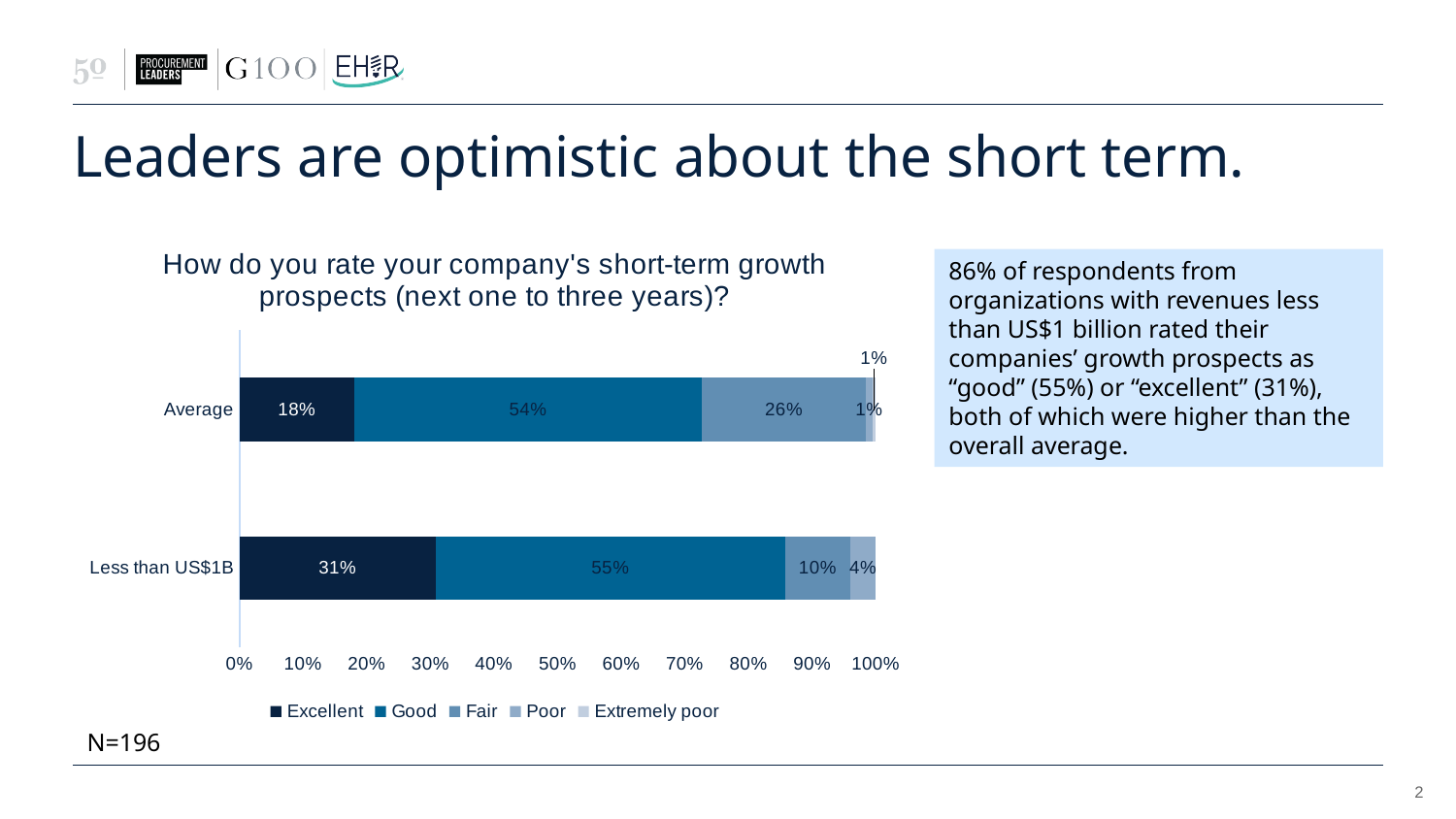
What is the 'Fair' value for the Average category? 26% What is the 'Poor' value for Less than US$1B? 4% How many series does the legend list? 5 What is the 'Good' value for the Average category? 54% What is the 'Excellent' value for Less than US$1B? 31% What is the difference between the 'Fair' values for Average and Less than US$1B? 16% How many categories are plotted on the y axis? 2 What is the title of the chart? How do you rate your company's short-term growth prospects (next one to three years)? Which series has the largest segment in the Average bar? Good What kind of chart is shown on the slide? Stacked bar chart Which category has the higher 'Excellent' value, Average or Less than US$1B? Less than US$1B What is the difference between the 'Excellent' values for Less than US$1B and Average? 13%